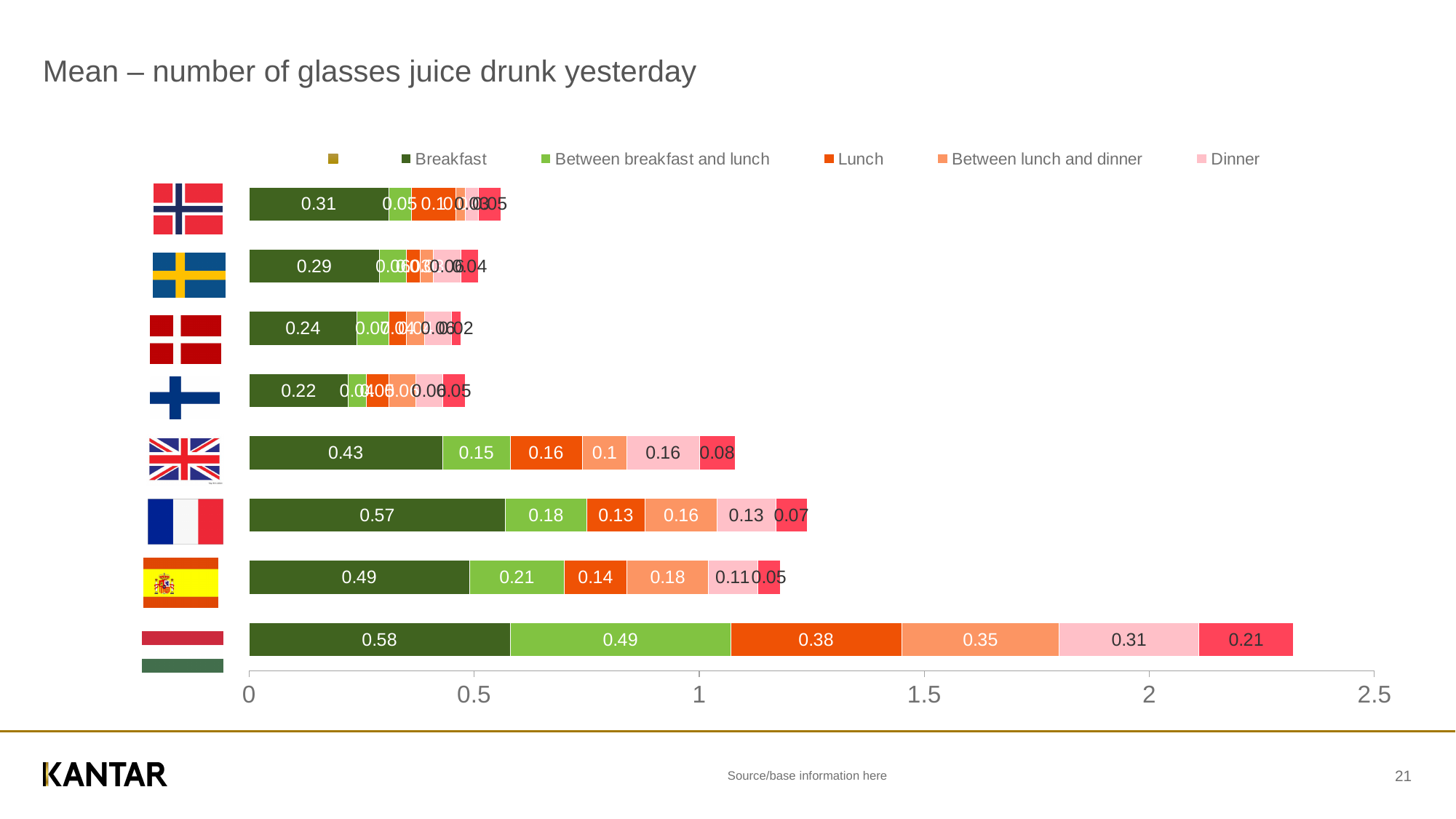
Which bar has the largest total? The bottom bar (Hungarian flag) Which has the larger Breakfast value: the bar with the Norwegian flag or the bar with the Swedish flag? Norwegian flag (0.31) What is the Dinner value for the bar with the Spanish flag? 0.11 How many named series does the legend list? 5 What is the difference between the Breakfast values for the French flag bar (0.57) and the Spanish flag bar (0.49)? 0.08 What is the Breakfast value for the bottom bar (Hungarian flag)? 0.58 What is the total of the bottom bar (Hungarian flag)? 2.32 What is the Lunch value for the bar with the UK flag? 0.16 How many bars (countries) does the chart show? 8 What is the title of the chart on the slide? Mean – number of glasses juice drunk yesterday What is the 'Between breakfast and lunch' value for the bar with the French flag? 0.18 What kind of chart is shown on the slide? Stacked bar chart